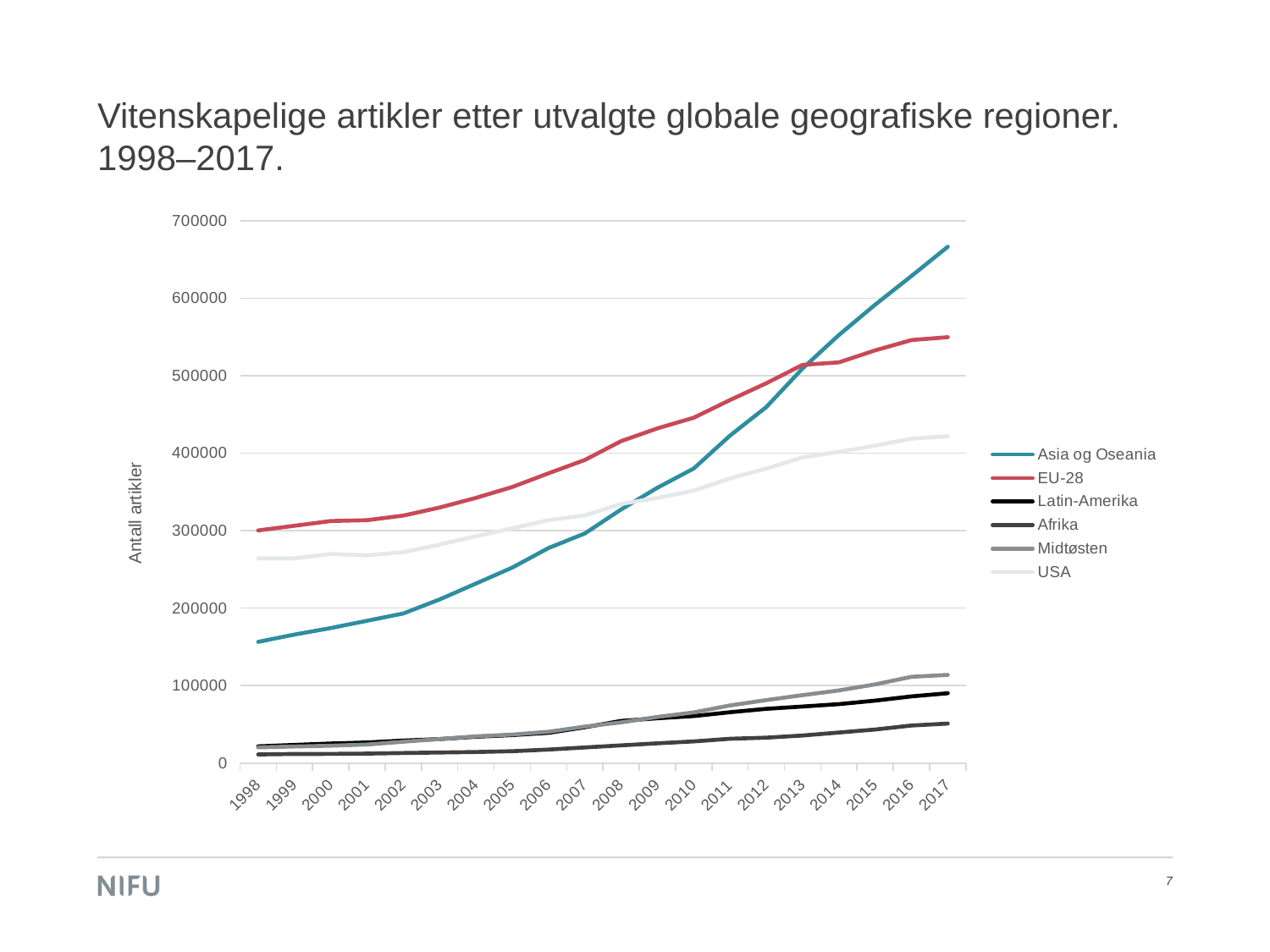
How many series does the legend list? 6 Which region has the lowest value in 2017? Afrika Does the Asia og Oseania line rise or fall from 1998 to 2017? rises Is the value for USA in 2017 greater or less than 400000? greater What is the label on the y axis? Antall artikler Is the value for Asia og Oseania in 1998 greater or less than 200000? less In 2010, which is larger: EU-28 or Asia og Oseania? EU-28 What kind of chart is shown on the slide? line chart Is the value for Asia og Oseania in 2017 greater or less than 600000? greater Which region has the highest value in 2017? Asia og Oseania Which region has the highest value in 1998? EU-28 How many years are plotted along the x axis? 20